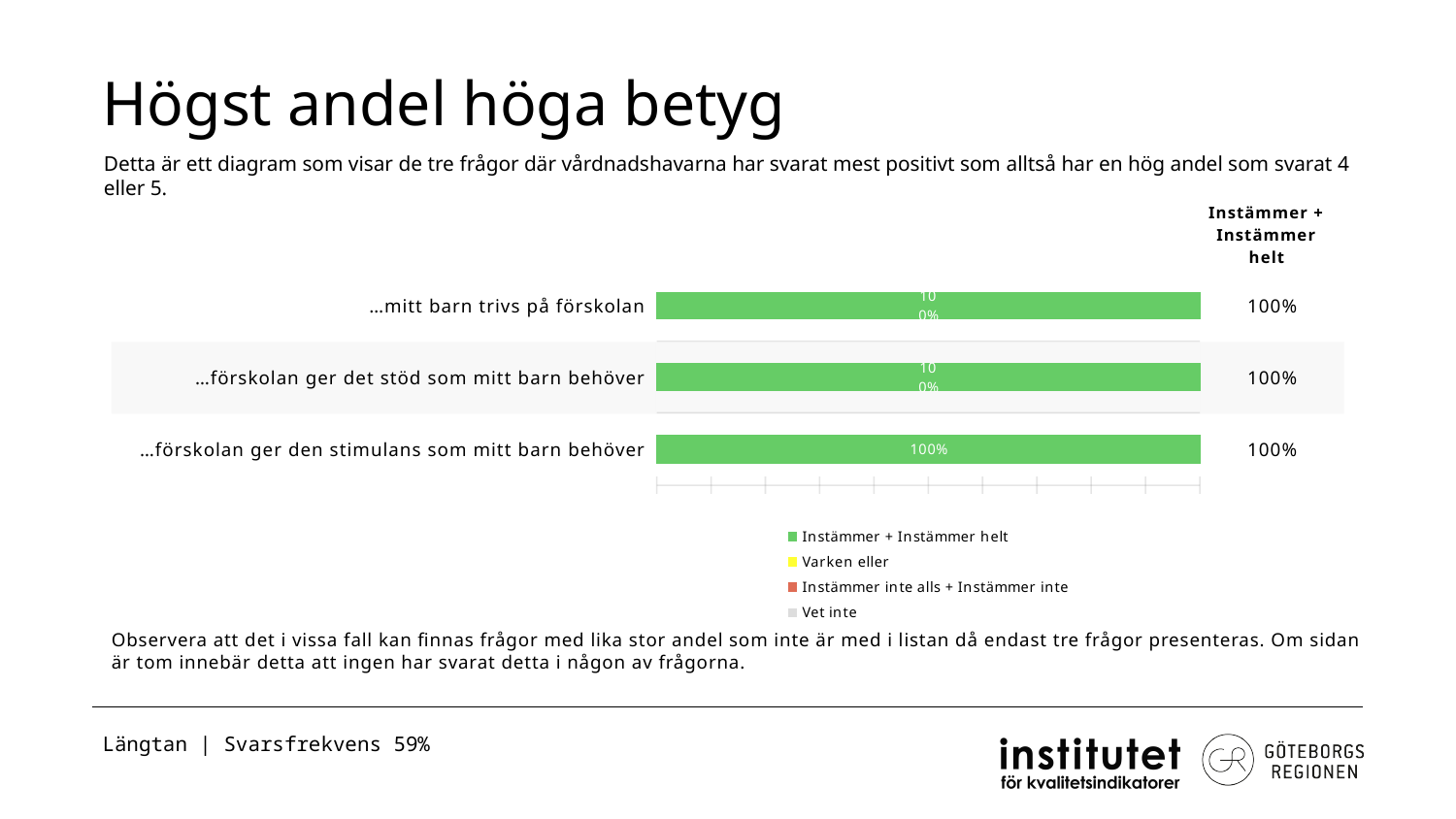
What is the 'Instämmer + Instämmer helt' value for '…förskolan ger den stimulans som mitt barn behöver'? 100% What is the total of the stacked bar for '…förskolan ger det stöd som mitt barn behöver'? 100% Which colour represents 'Instämmer + Instämmer helt' in the legend? green How many series does the chart legend list? 4 What is the title of the slide containing the chart? Högst andel höga betyg How many categories (questions) are plotted in the chart? 3 What is the 'Instämmer + Instämmer helt' value for '…mitt barn trivs på förskolan'? 100% What is the 'Instämmer + Instämmer helt' value for '…förskolan ger det stöd som mitt barn behöver'? 100% What is the difference between the 'Instämmer + Instämmer helt' values for '…mitt barn trivs på förskolan' and '…förskolan ger den stimulans som mitt barn behöver'? 0% What kind of chart is shown on the slide? bar chart What is the heading of the column of values to the right of the bars? Instämmer + Instämmer helt